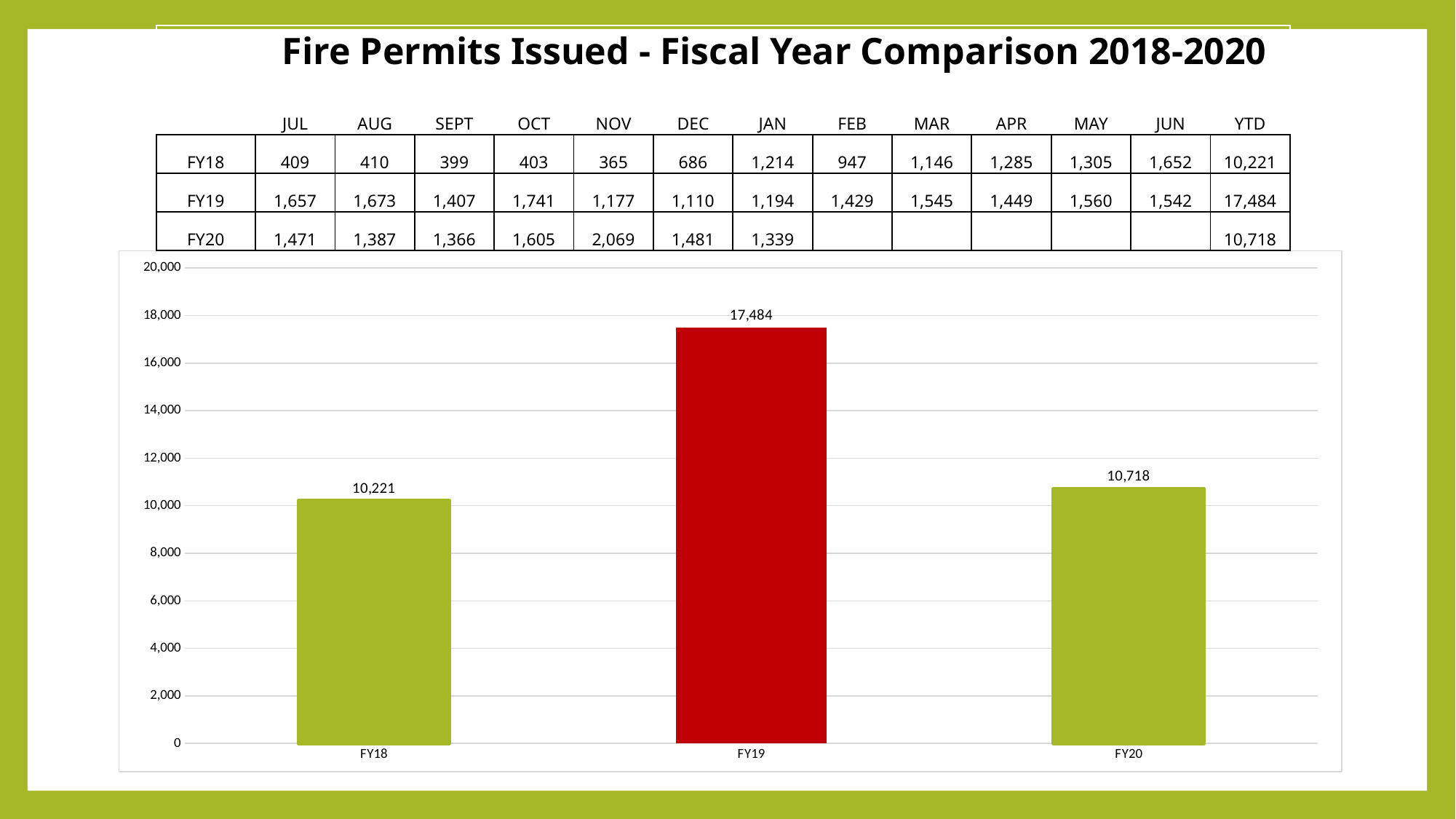
Which is larger, the FY19 bar or the FY20 bar? FY19 How many bars are shown in the chart? 3 What is the value of the FY19 bar? 17,484 Is the value for FY20 greater or less than 12,000? less What is the difference between the FY19 and FY18 bar values? 7,263 What colour is the FY19 bar? red What kind of chart is shown on the slide? bar chart Which fiscal year has the highest bar? FY19 What is the value of the FY20 bar? 10,718 What is the difference between the FY20 and FY18 bar values? 497 Which fiscal year has the lowest bar? FY18 What is the value of the FY18 bar? 10,221